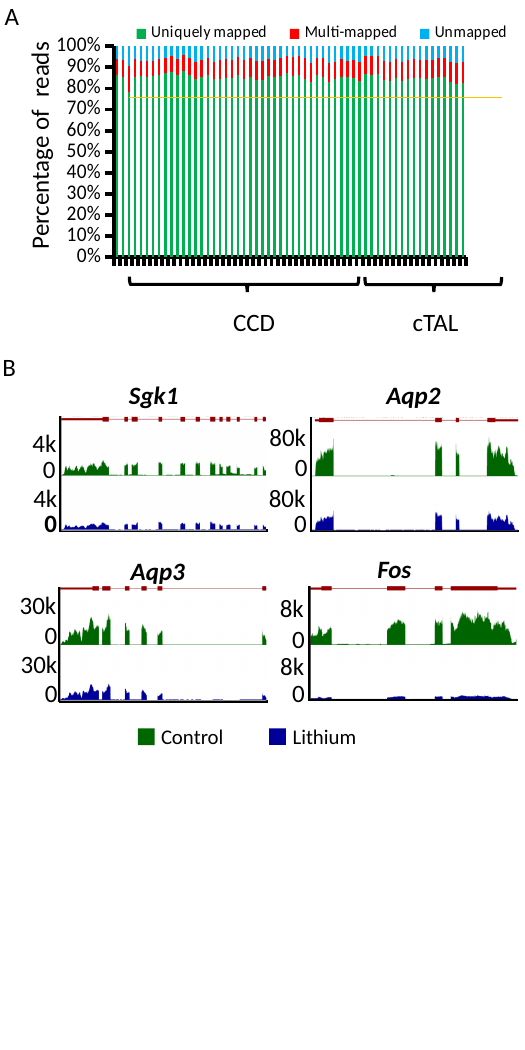
What are the two sample groups labelled under the panel A chart? CCD and cTAL In the panel A chart, which is larger in each bar: the Uniquely mapped share or the Unmapped share? Uniquely mapped In the panel A chart, is the Uniquely mapped share of each bar greater or less than 70%? greater In panel B, what is the top y-axis value shown for the Aqp2 tracks? 80k In panel B, what is the top y-axis value shown for the Fos tracks? 8k How many sample groups are labelled under the x axis of the panel A chart? 2 What is the y-axis label of the panel A chart? Percentage of reads What kind of chart is shown in panel A? Stacked bar chart How many conditions does the legend of panel B list? 2 In the panel A chart, which series makes up the largest share of every bar? Uniquely mapped How many series does the legend of the panel A chart list? 3 How many genes are shown in the panel B tracks? 4